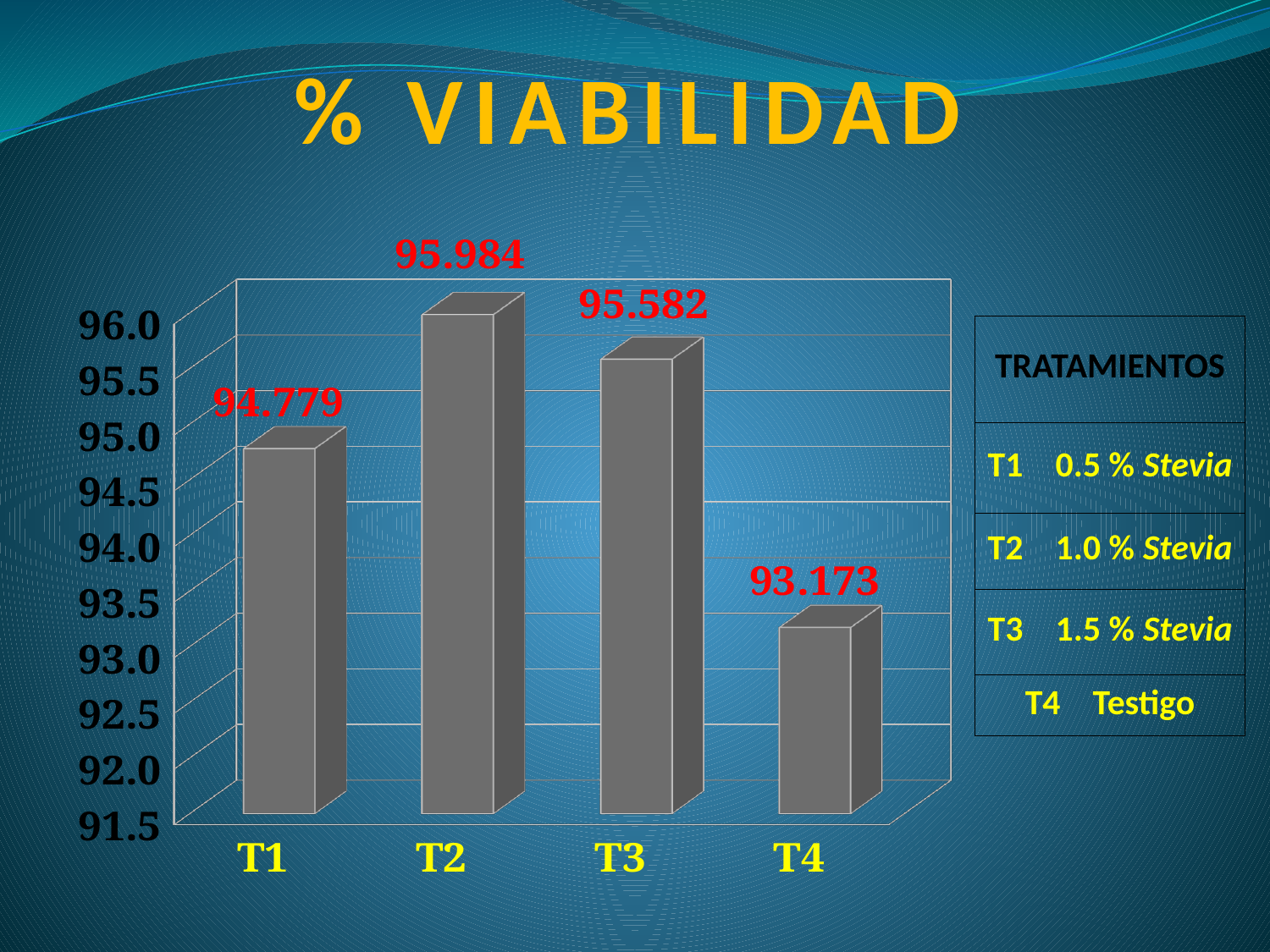
What kind of chart is shown on the slide? bar chart Which has a higher % viabilidad, T1 or T3? T3 What is the % viabilidad value for T2? 95.984 What is the % viabilidad value for T4? 93.173 What is the difference in % viabilidad between T2 and T4? 2.811 Which treatment has the lowest % viabilidad? T4 Is the value for T4 greater or less than 93.5? less What is the % viabilidad value for T1? 94.779 What is the % viabilidad value for T3? 95.582 Which treatment has the highest % viabilidad? T2 How many treatments are plotted on the chart? 4 According to the table on the slide, what does treatment T4 correspond to? Testigo